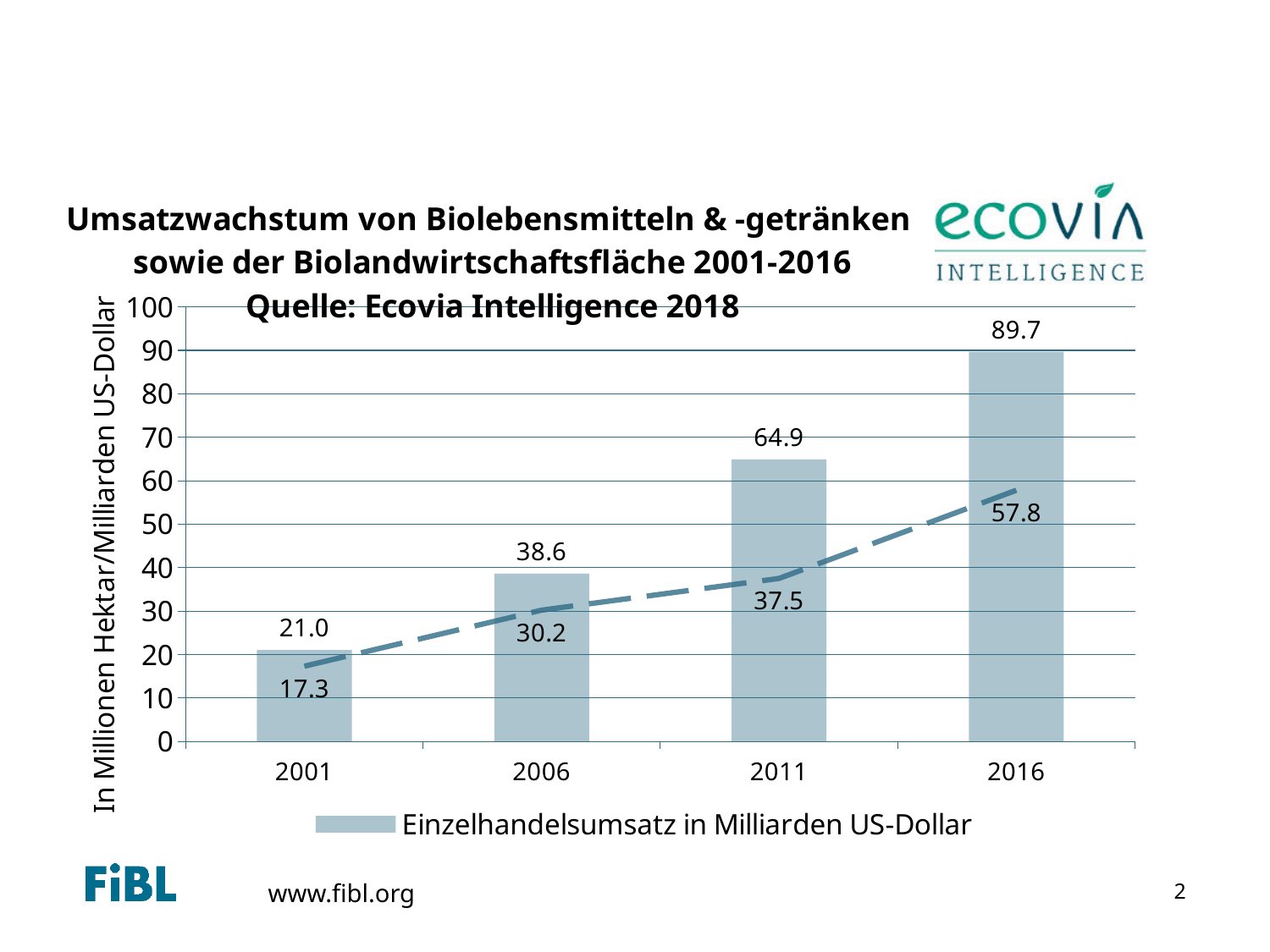
Do the Einzelhandelsumsatz bars rise or fall from 2001 to 2016? Rise What is the source given in the chart title? Ecovia Intelligence 2018 Which year has the highest Einzelhandelsumsatz in Milliarden US-Dollar? 2016 What value does the dashed line show for 2016? 57.8 How many years are shown on the x axis? 4 Which year has the lowest value on the dashed line? 2001 How many series does the legend list? 1 Which is larger in 2006: the bar value or the dashed line value? The bar value (38.6) What is the Einzelhandelsumsatz in Milliarden US-Dollar for 2016? 89.7 What is the difference between the Einzelhandelsumsatz in Milliarden US-Dollar for 2016 and 2011? 24.8 What is the Einzelhandelsumsatz in Milliarden US-Dollar for 2001? 21.0 What value does the dashed line show for 2011? 37.5